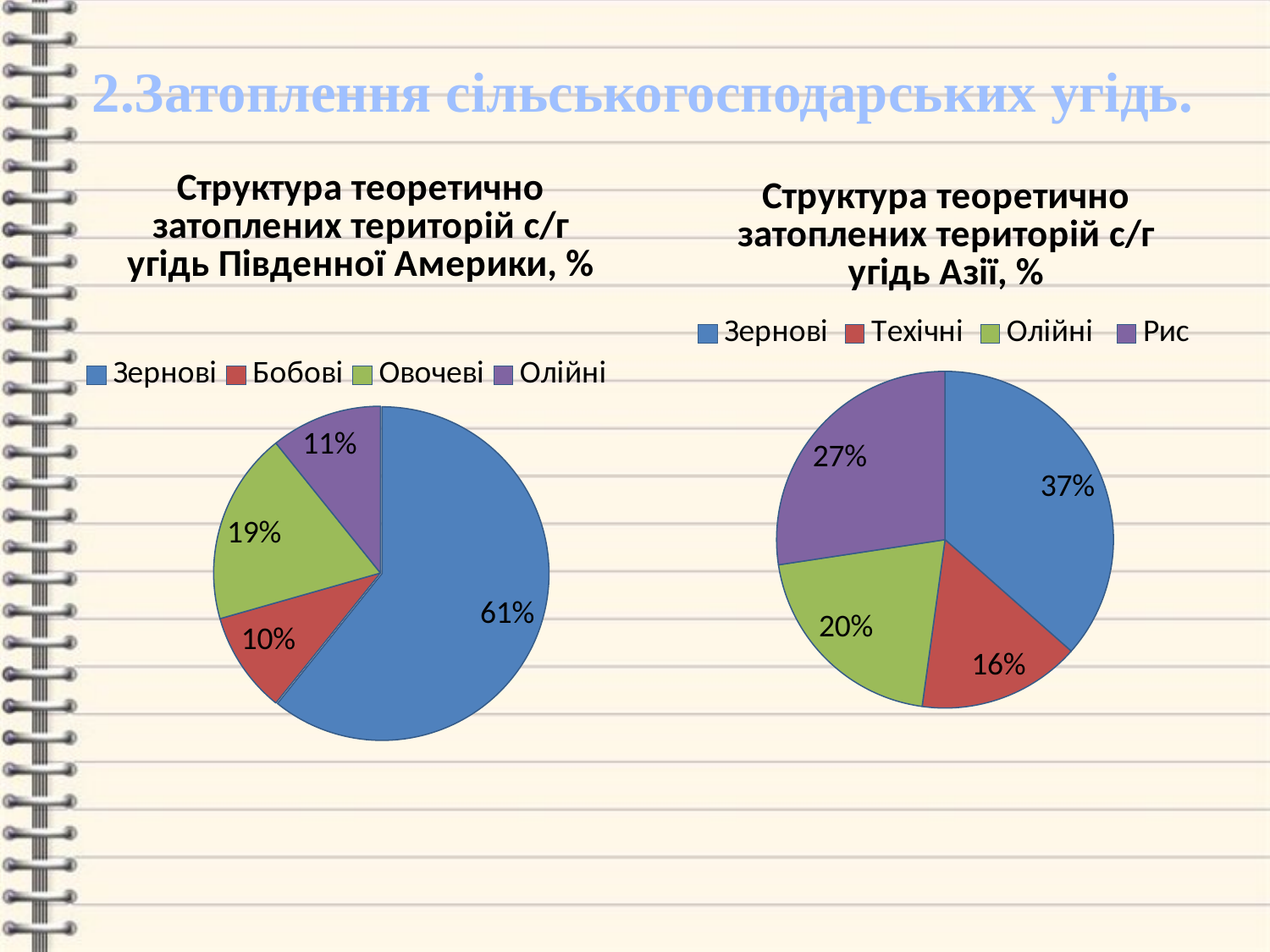
In the left pie chart (South America), what share is labelled for Зернові? 61% How many slices does the right pie chart (Asia) have? 4 In the right pie chart (Asia), which category has the smallest slice? Техічні What type of chart is used on the left side of the slide? Pie chart In the right pie chart (Asia), what is the difference between the shares of Зернові and Олійні? 17% In the left pie chart (South America), what share is labelled for Бобові? 10% In the right pie chart (Asia), what share is labelled for Рис? 27% In the left pie chart (South America), which is larger: Овочеві or Олійні? Овочеві In the left pie chart (South America), which category has the largest slice? Зернові In the right pie chart (Asia), what share is labelled for Техічні? 16% In the left pie chart (South America), which category has the smallest slice? Бобові How many entries does the legend of the left pie chart (South America) list? 4